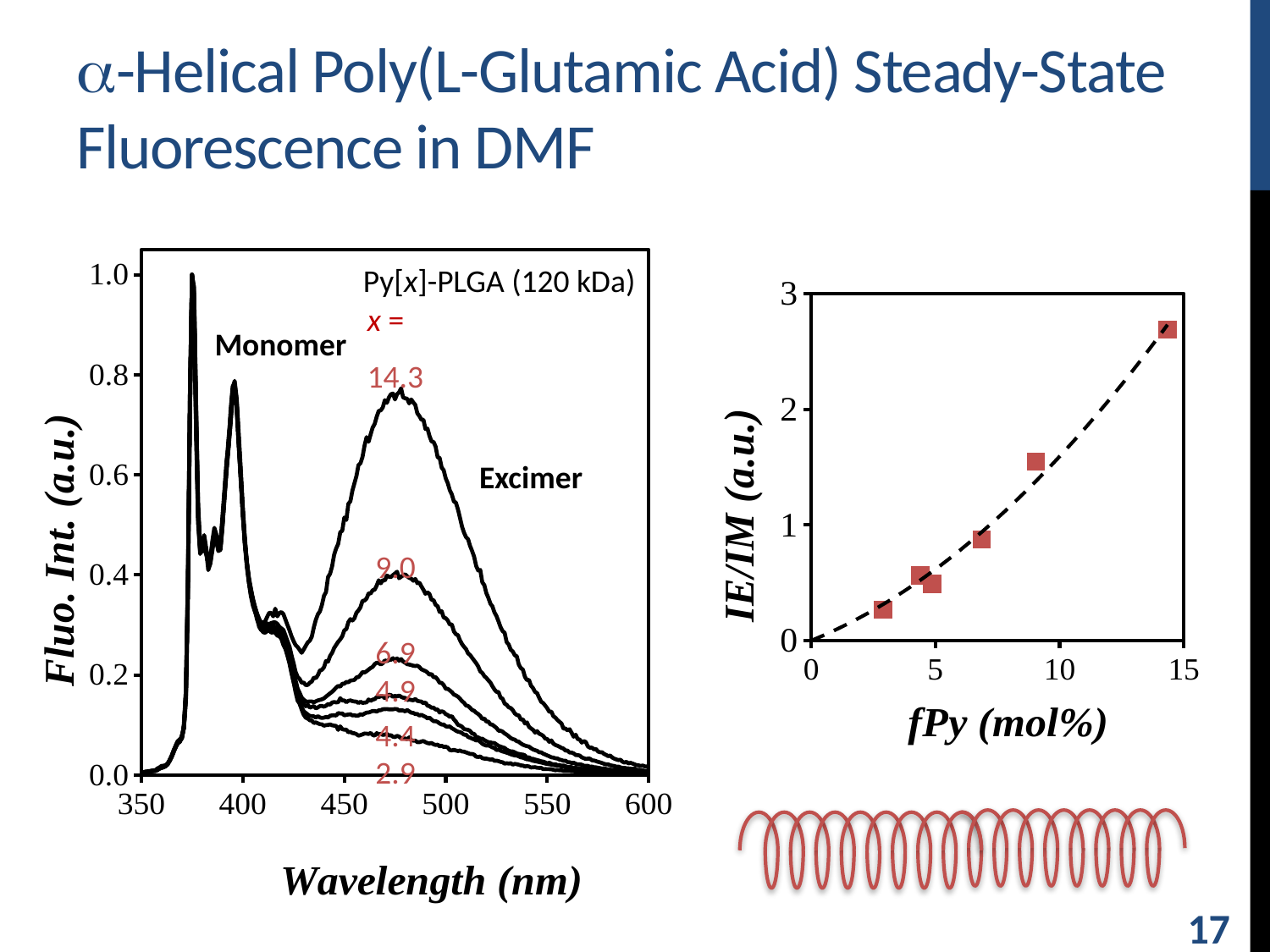
In the right chart, is the IE/IM value of the point near fPy = 14 greater or less than 2? greater What kind of chart is the right chart (IE/IM vs fPy)? scatter plot In the right chart, does IE/IM rise or fall as fPy increases? rise What kind of chart is the left chart (Fluo. Int. vs Wavelength)? line chart In the left chart, is the excimer peak of the x = 14.3 curve greater or less than 0.6? greater In the right chart, how many data points are plotted? 6 In the left chart, which labelled x value has the lowest excimer intensity? 2.9 In the left chart, which labelled x value has the highest excimer peak? 14.3 In the left chart, how many spectra (x values) are labelled? 6 In the left chart, is the excimer peak of the x = 9.0 curve greater or less than 0.6? less What is the x-axis label of the left chart? Wavelength (nm) What is the x-axis label of the right chart? fPy (mol%)